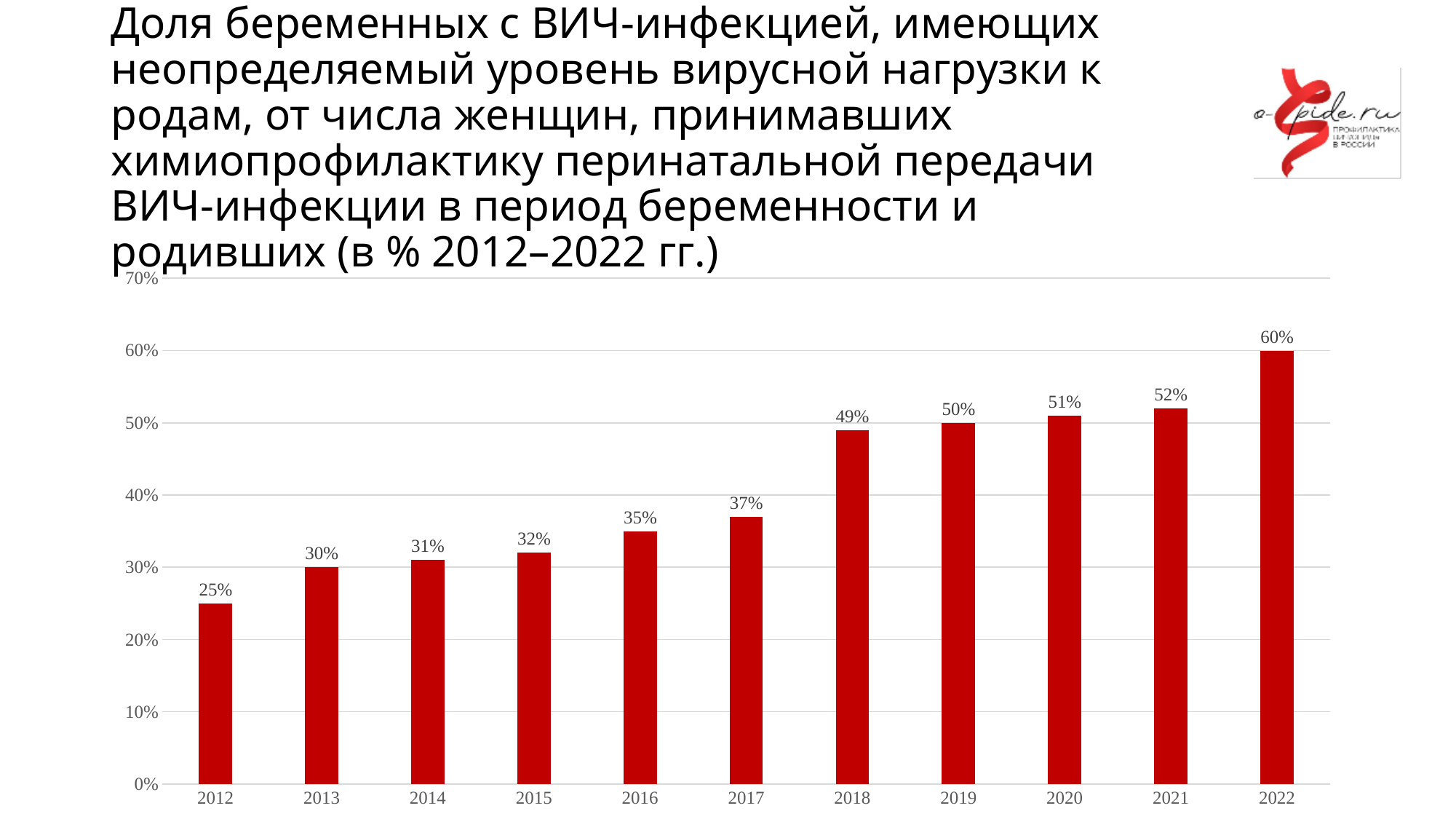
What is the difference between the values for 2022 and 2012? 35% Is the value for 2017 greater or less than 40%? less Which is larger, the value for 2016 or the value for 2019? 2019 What is the value for 2022? 60% What is the value for 2012? 25% Do the values rise or fall from 2012 to 2022? rise What kind of chart is shown on the slide? bar chart What is the value for 2018? 49% How many years are shown on the x axis? 11 Which year has the lowest value? 2012 Which year has the highest value? 2022 What is the difference between the values for 2018 and 2017? 12%